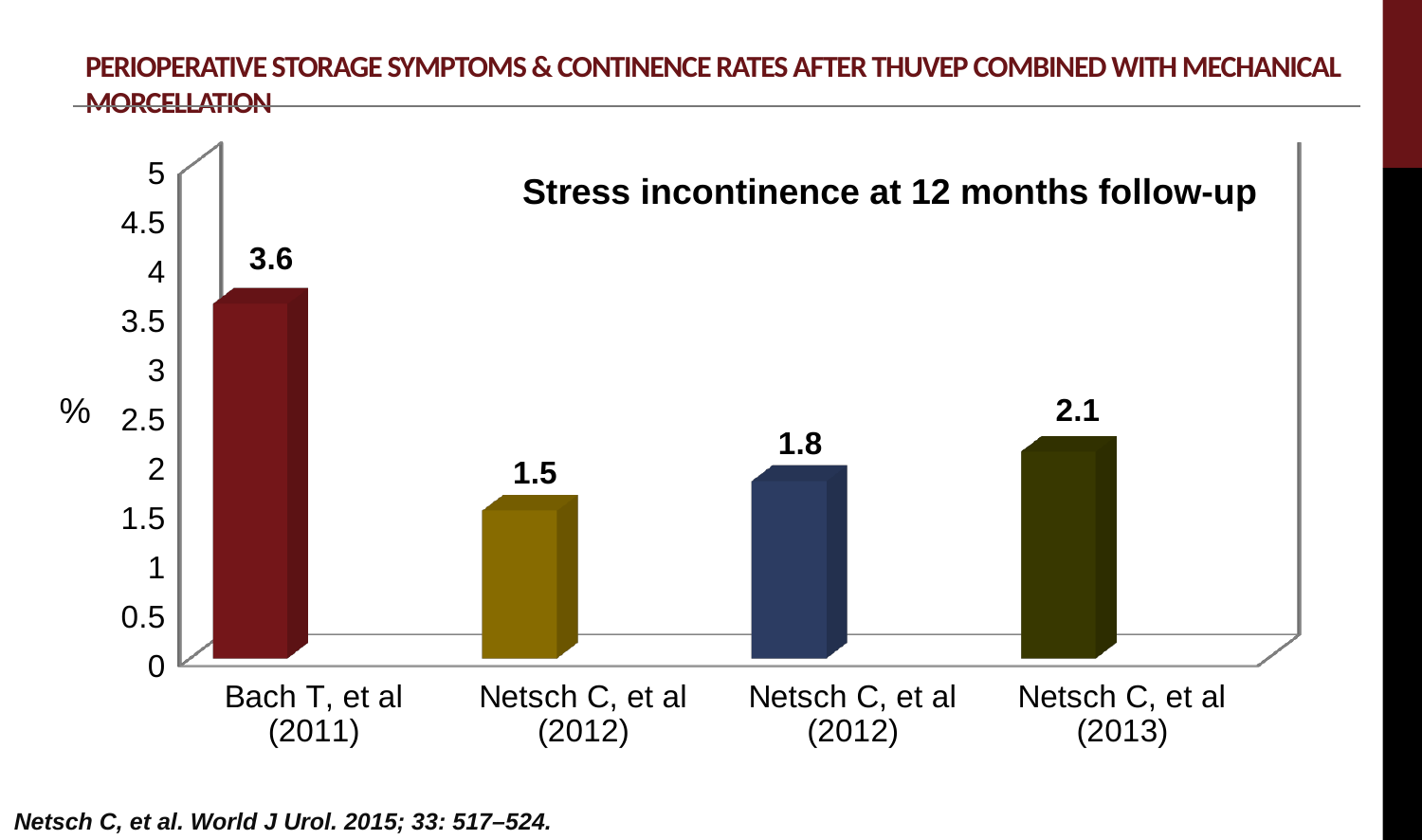
What is the title of the chart? Stress incontinence at 12 months follow-up What is the value shown for Netsch C, et al (2013)? 2.1 What is the difference between the values for Bach T, et al (2011) and Netsch C, et al (2013)? 1.5 What is the stress incontinence rate at 12 months follow-up for Bach T, et al (2011)? 3.6 How many bars are shown in the chart? 4 Which is larger, the value for Netsch C, et al (2013) or the value of the third bar (Netsch C, et al 2012)? Netsch C, et al (2013) What is the value of the second bar from the left, the first Netsch C, et al (2012) bar? 1.5 Is the value for Bach T, et al (2011) greater or less than 3? greater Which bar shows the lowest value? The second bar, Netsch C, et al (2012), at 1.5 What is the value of the third bar from the left, the second Netsch C, et al (2012) bar? 1.8 Which study has the highest stress incontinence rate at 12 months follow-up? Bach T, et al (2011) What type of chart is shown on the slide? Bar chart